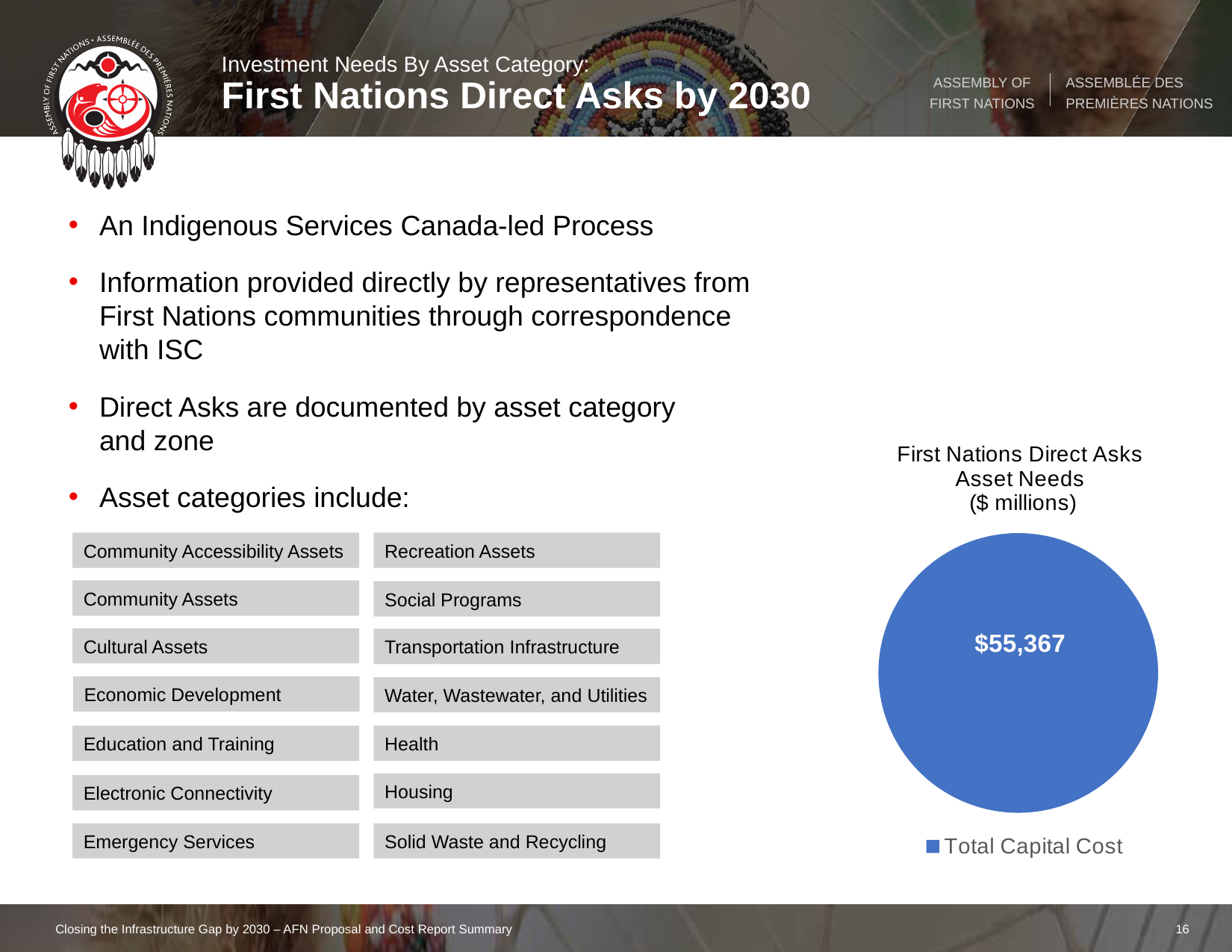
What share of the pie does the Total Capital Cost slice represent? 100% How many slices does the pie chart have? 1 What is the value shown on the pie chart for Total Capital Cost? $55,367 In what units are the values in the pie chart expressed? $ millions What is the title of the pie chart? First Nations Direct Asks Asset Needs ($ millions) How many series does the chart legend list? 1 What is the legend entry for the pie chart? Total Capital Cost What kind of chart is shown on the slide? pie chart